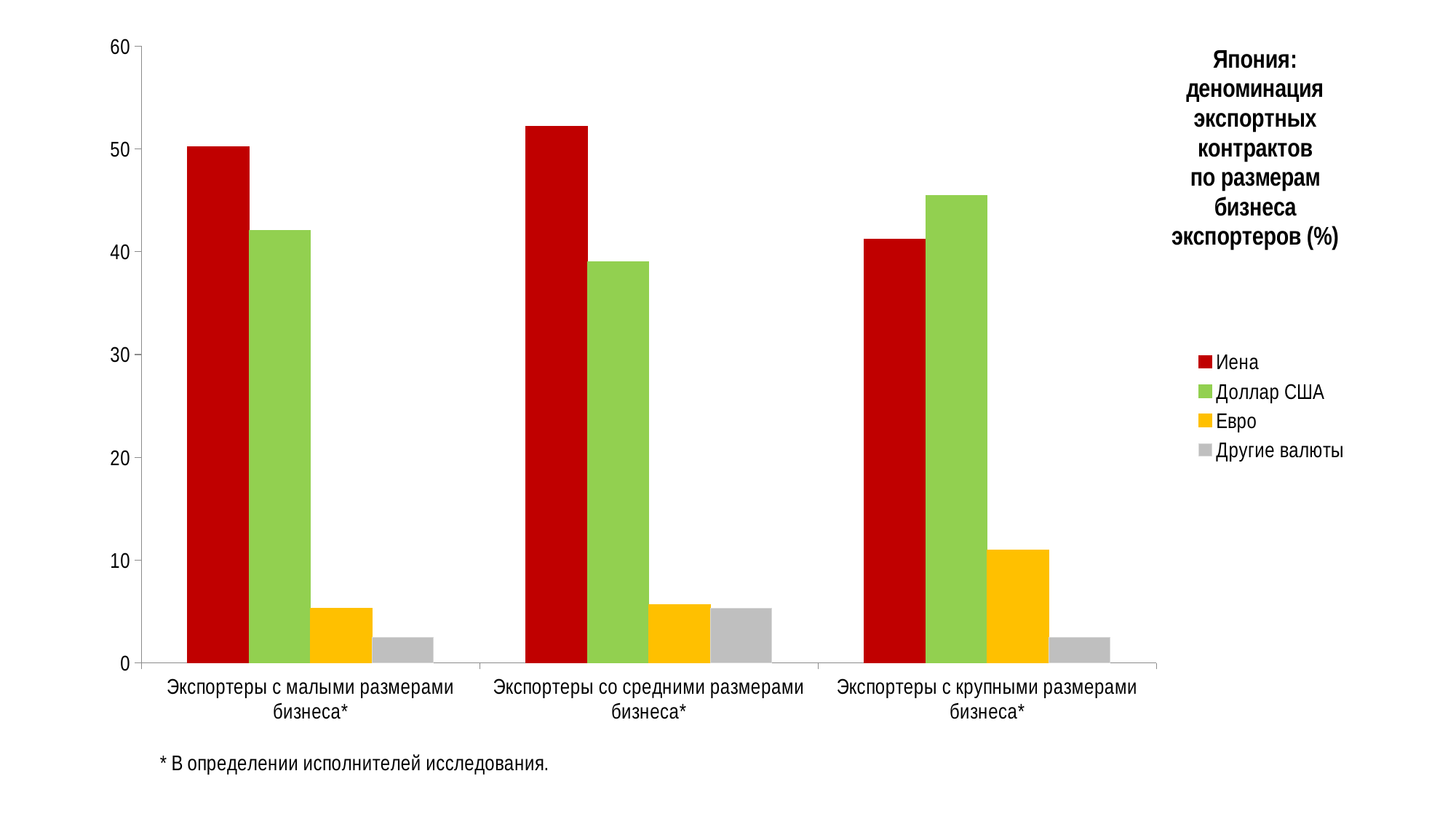
Is the value for Иена among Экспортеры с крупными размерами бизнеса greater or less than 50? less Which currency has the highest bar for Экспортеры с малыми размерами бизнеса? Иена For Экспортеры с крупными размерами бизнеса, which is larger: Иена or Доллар США? Доллар США What kind of chart is shown on the slide? bar chart Is the value for Иена among Экспортеры со средними размерами бизнеса greater or less than 50? greater How many series does the legend list? 4 How many exporter size categories are shown on the x axis? 3 Which currency has the lowest bar for Экспортеры с малыми размерами бизнеса? Другие валюты Which currency has the highest bar for Экспортеры с крупными размерами бизнеса? Доллар США What colour represents Иена in the legend? red Does the Евро share rise or fall as exporter size goes from small to medium to large? rise Is the value for Евро among Экспортеры с крупными размерами бизнеса greater or less than 10? greater